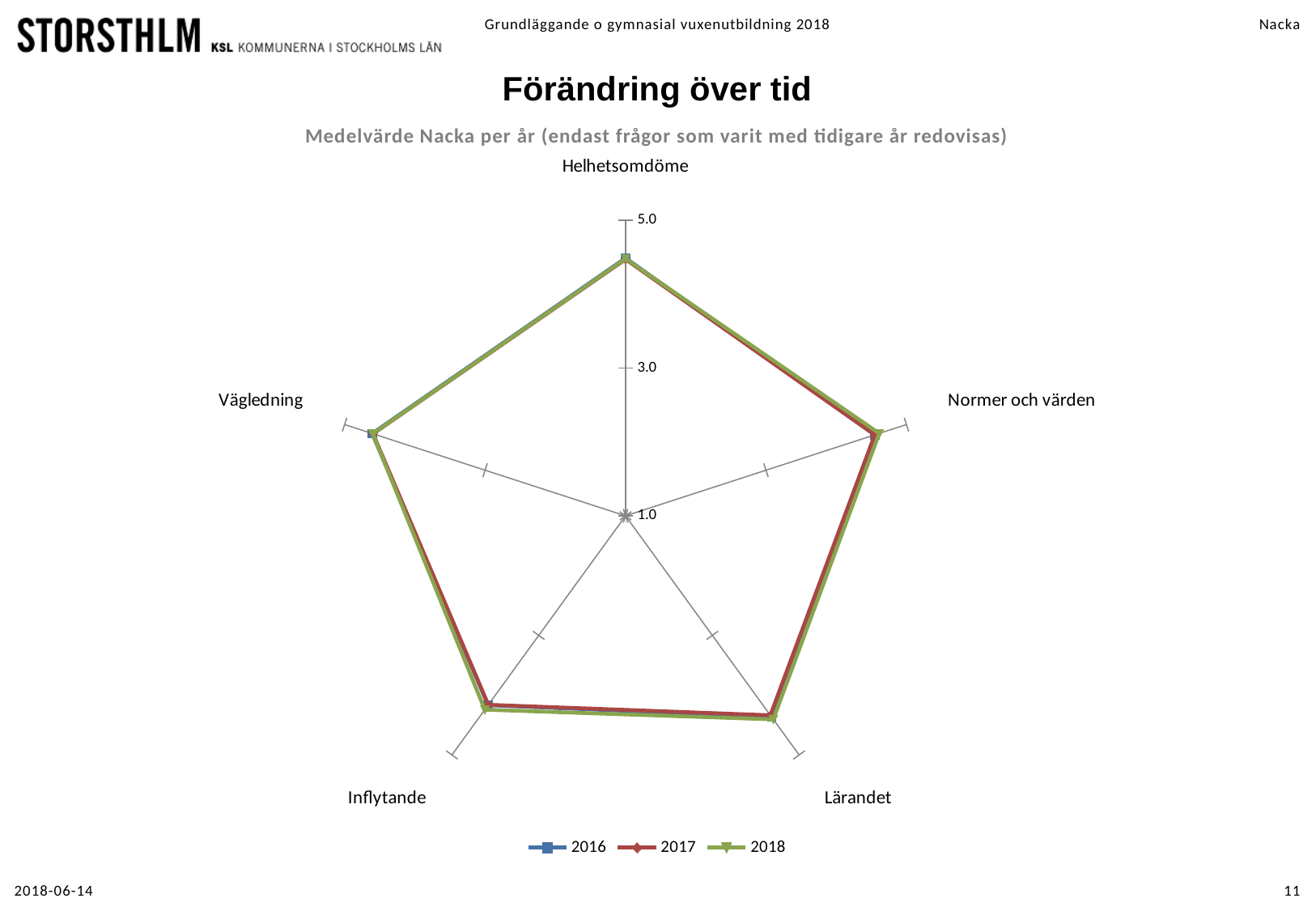
How many categories (axes) does the radar chart have? 5 Which years are listed in the legend? 2016, 2017, 2018 Is the 2018 value for Inflytande greater or less than 3.0? greater Is the 2017 value for Normer och värden greater or less than 3.0? greater What is the title of the chart? Förändring över tid Which category is at the top of the radar chart? Helhetsomdöme What kind of chart is shown on the slide? radar chart Is the 2018 value for Helhetsomdöme greater or less than 3.0? greater How many series does the legend list? 3